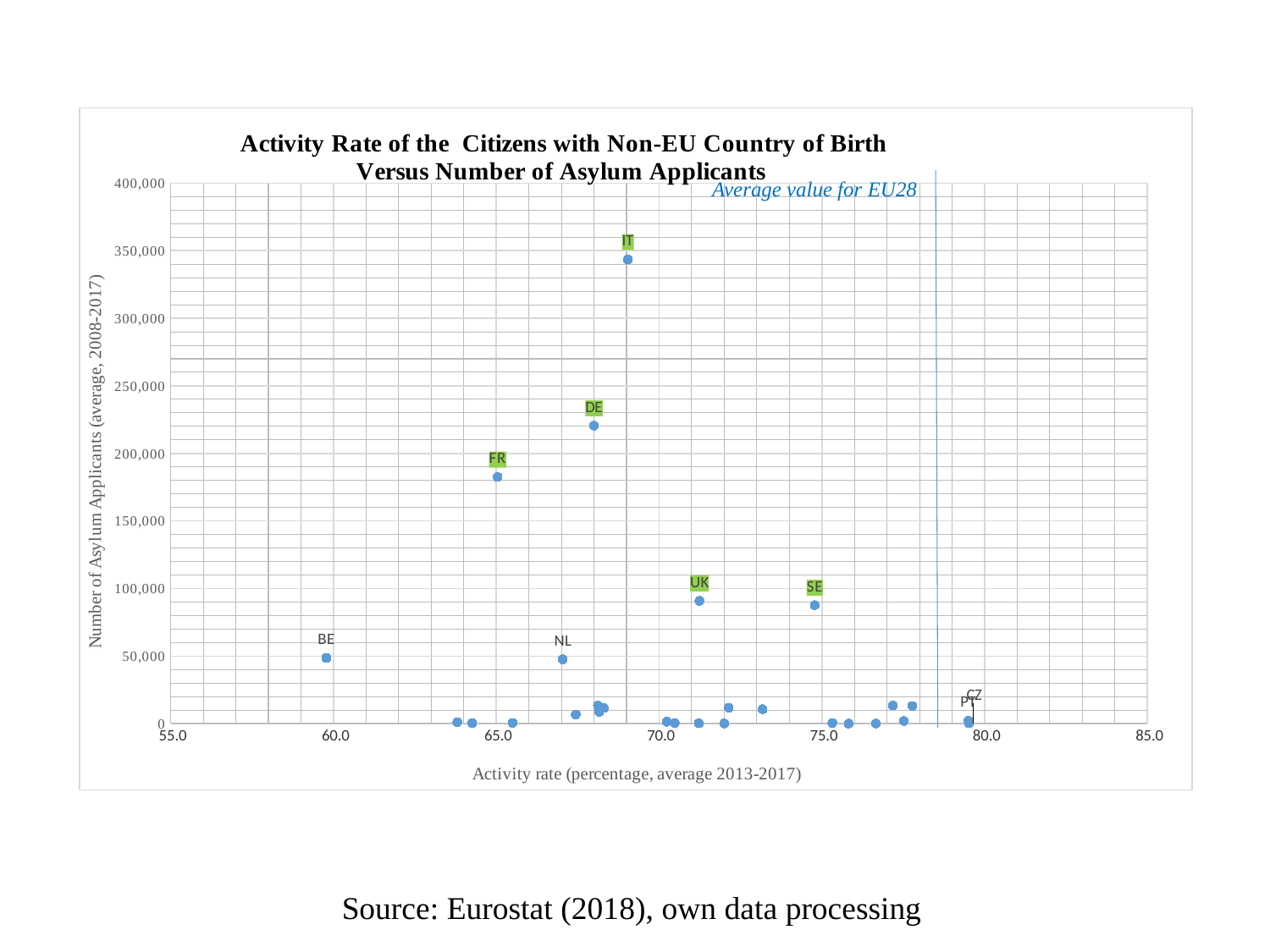
Is the number of asylum applicants for IT greater or less than 300,000? greater Is the number of asylum applicants for DE greater or less than 200,000? greater What is the title of the chart? Activity Rate of the Citizens with Non-EU Country of Birth Versus Number of Asylum Applicants Which labelled country has the highest number of asylum applicants? IT Which has more asylum applicants, DE or FR? DE Is the activity rate for UK greater or less than 70.0? greater What does the vertical blue line in the chart represent? Average value for EU28 What kind of chart is shown on the slide? scatter chart